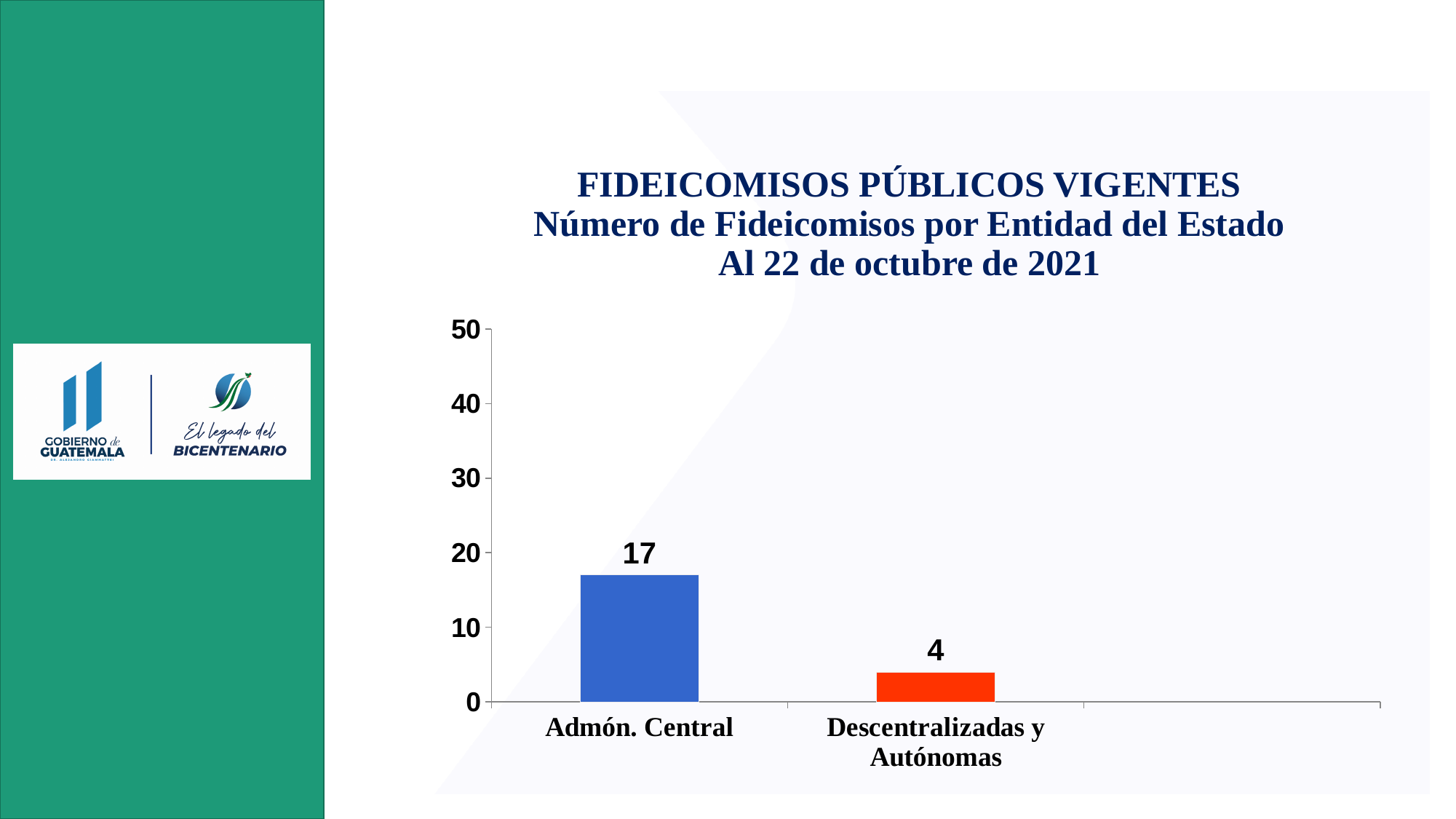
What is the difference between the values for Admón. Central and Descentralizadas y Autónomas? 13 What kind of chart is shown on the slide? Bar chart Is the value for Descentralizadas y Autónomas greater or less than 10? less Is the value for Admón. Central greater or less than 20? less What date does the chart title say the data is as of? 22 de octubre de 2021 What is the value for Admón. Central? 17 Which is larger, the value for Admón. Central or the value for Descentralizadas y Autónomas? Admón. Central How many categories are shown on the chart? 2 What is the total of the two values shown on the chart? 21 Which category has the lowest value? Descentralizadas y Autónomas Which category has the highest value? Admón. Central What is the value for Descentralizadas y Autónomas? 4